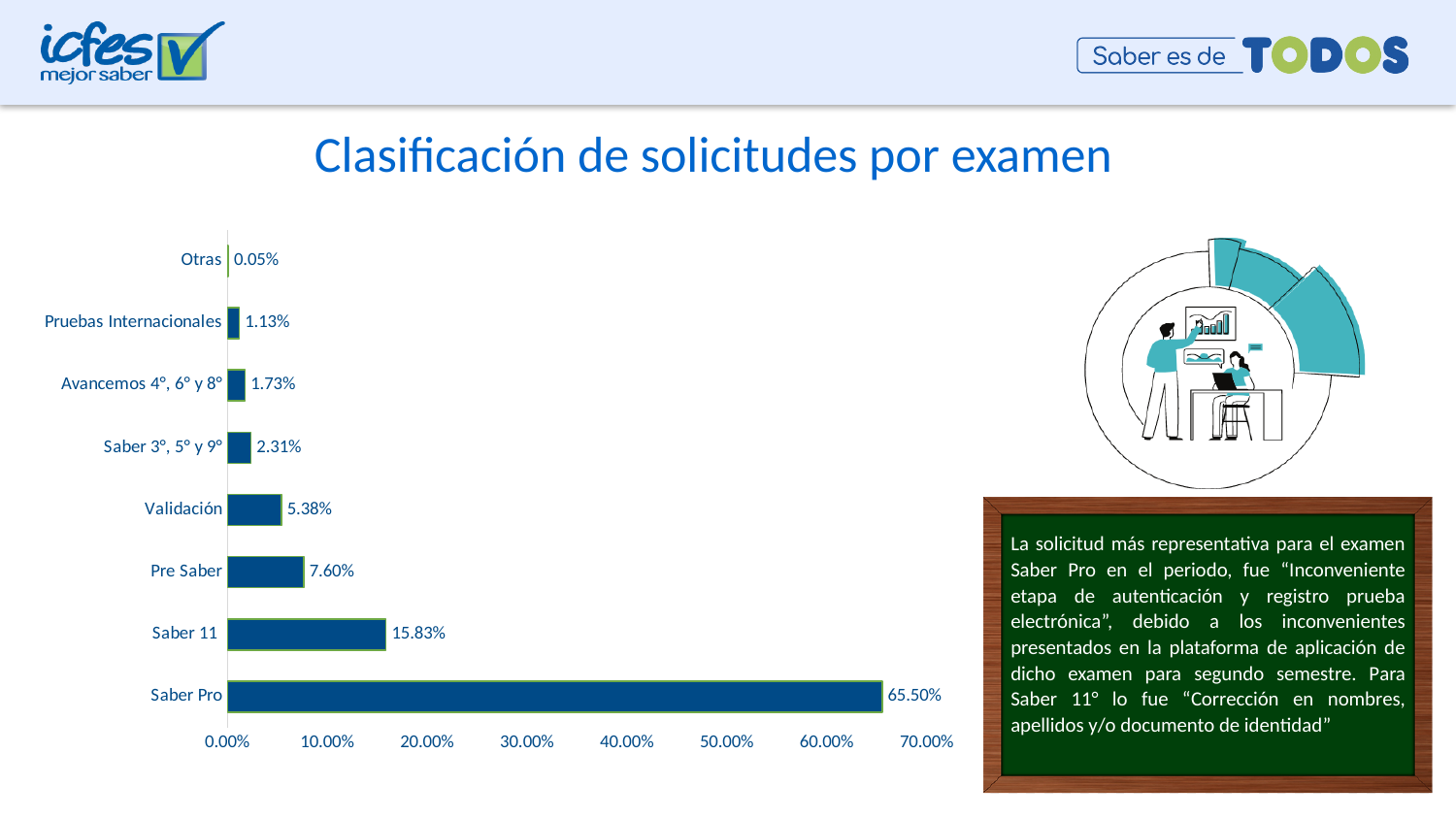
What is the difference between the values for Saber Pro and Saber 11? 49.67% Which is larger, the value for Pre Saber or the value for Validación? Pre Saber How many categories are shown in the chart? 8 What is the title of the chart on the slide? Clasificación de solicitudes por examen What is the value for Saber 11? 15.83% What is the value for Pruebas Internacionales? 1.13% Which category has the lowest value? Otras What is the value for Validación? 5.38% What is the value for Saber Pro? 65.50% Is the value for Saber Pro greater or less than 60.00%? greater Which category has the highest value? Saber Pro What type of chart is shown on the slide? Bar chart